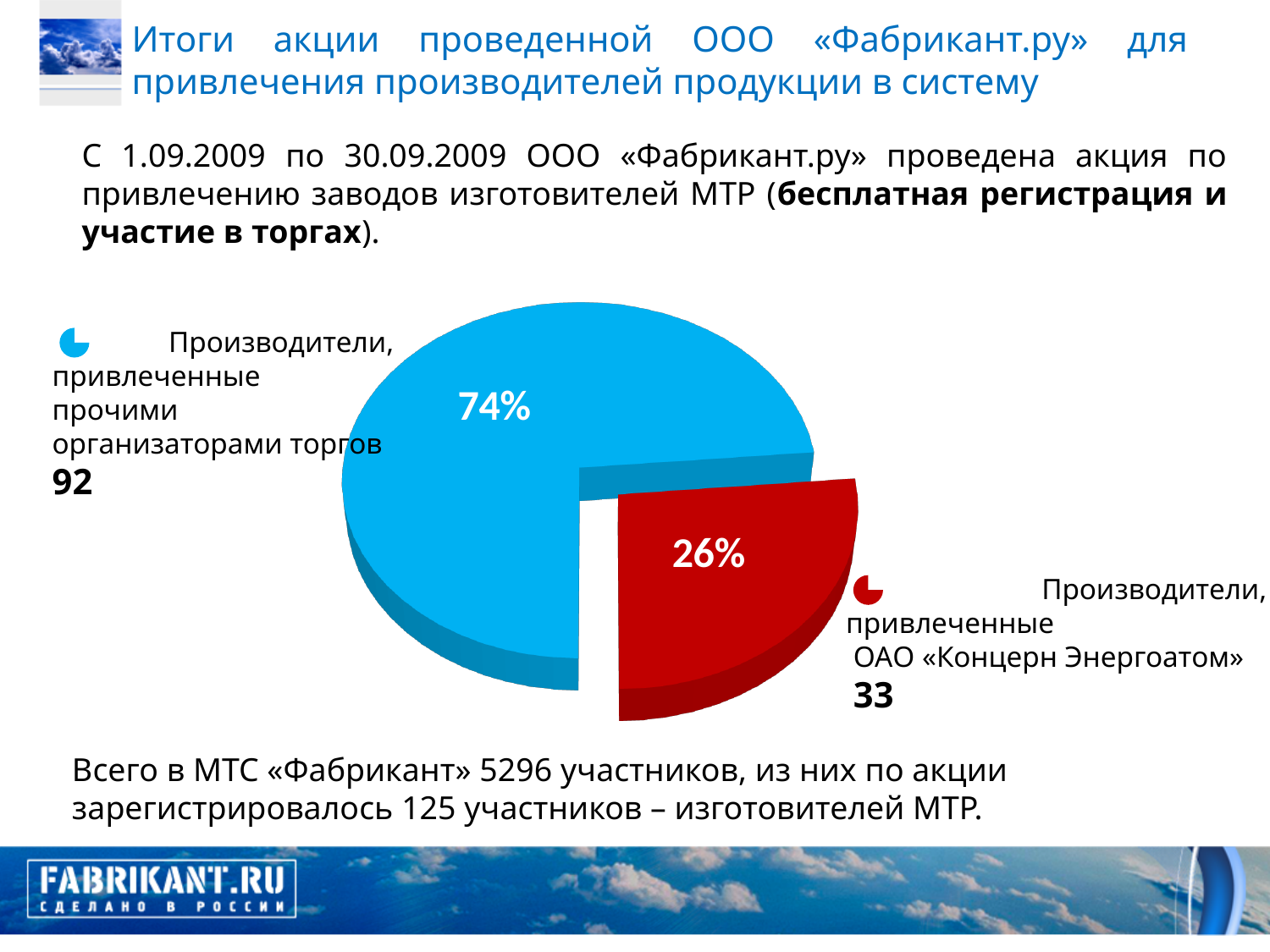
What kind of chart is shown on the slide? Pie chart What colour is the slice representing producers attracted by ОАО «Концерн Энергоатом»? Red What is the difference in percentage points between the 74% slice and the 26% slice? 48 How many slices does the pie chart have? 2 What percentage share is shown for the slice 'Производители, привлеченные ОАО «Концерн Энергоатом»'? 26% Which slice of the pie chart is the largest? Производители, привлеченные прочими организаторами торгов How many producers were attracted by 'прочими организаторами торгов' according to the chart labels? 92 What percentage share is shown for the slice 'Производители, привлеченные прочими организаторами торгов'? 74% How many producers were attracted by 'ОАО «Концерн Энергоатом»' according to the chart labels? 33 What is the difference between the number of producers attracted by other trade organizers (92) and by ОАО «Концерн Энергоатом» (33)? 59 Which is larger: the share of producers attracted by ОАО «Концерн Энергоатом» or the share attracted by other trade organizers? Other trade organizers (прочими организаторами торгов) Which slice of the pie chart is the smallest? Производители, привлеченные ОАО «Концерн Энергоатом»